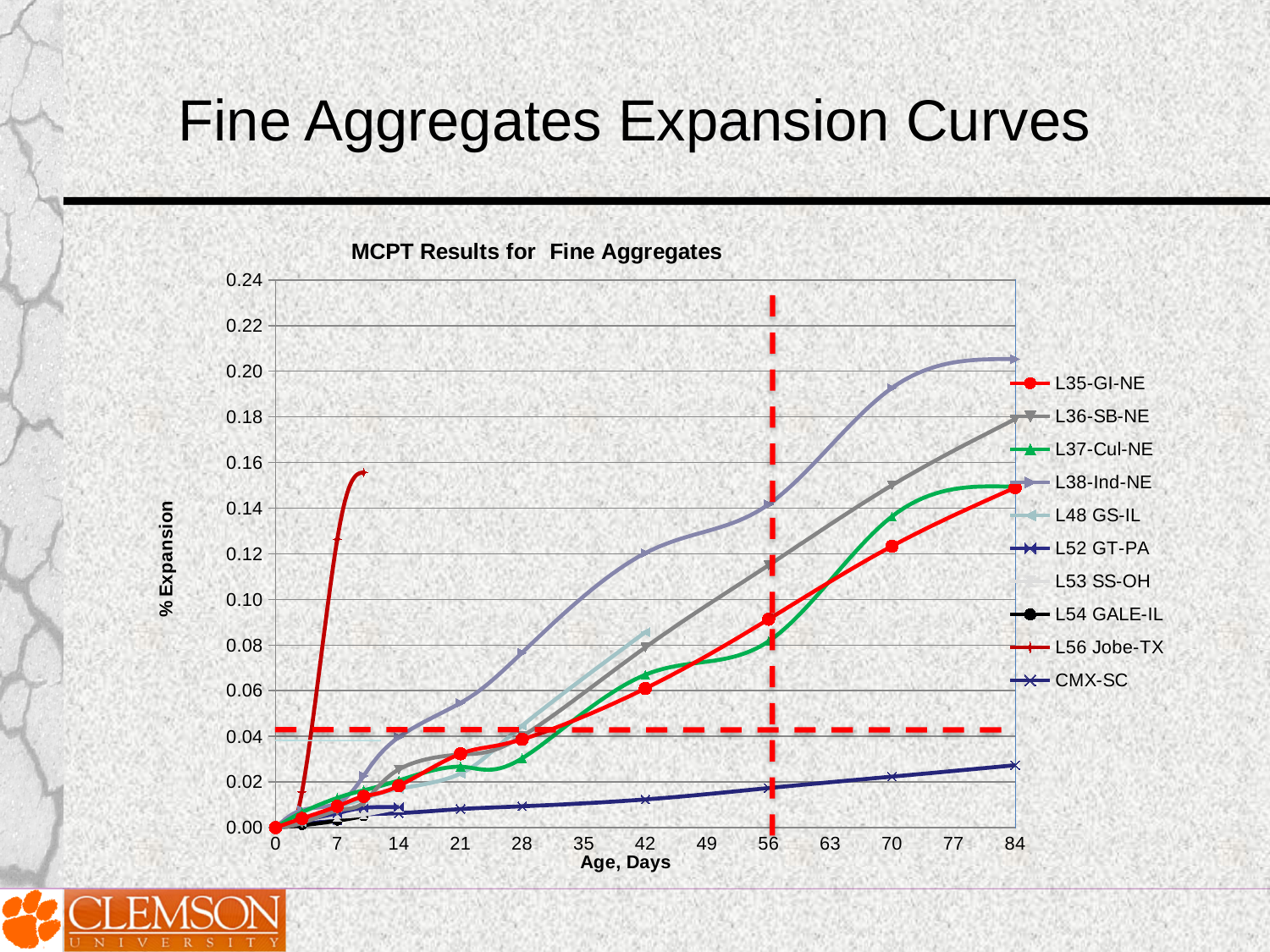
Which series has the highest % Expansion at 84 days? L38-Ind-NE What is the label of the y axis? % Expansion Does the % Expansion for L35-GI-NE rise or fall as Age, Days increases? rise Which series has the lowest % Expansion at 84 days? CMX-SC Is the % Expansion for L35-GI-NE at 56 days greater or less than 0.08? greater What is the title of the chart? MCPT Results for Fine Aggregates At 56 days, which series has the larger % Expansion, L38-Ind-NE or L36-SB-NE? L38-Ind-NE Is the % Expansion for L38-Ind-NE at 70 days greater or less than 0.18? greater What kind of chart is shown on the slide? line chart How many series does the legend list? 10 Is the % Expansion for CMX-SC at 84 days greater or less than 0.04? less At 84 days, which series has the larger % Expansion, L36-SB-NE or L37-Cul-NE? L36-SB-NE